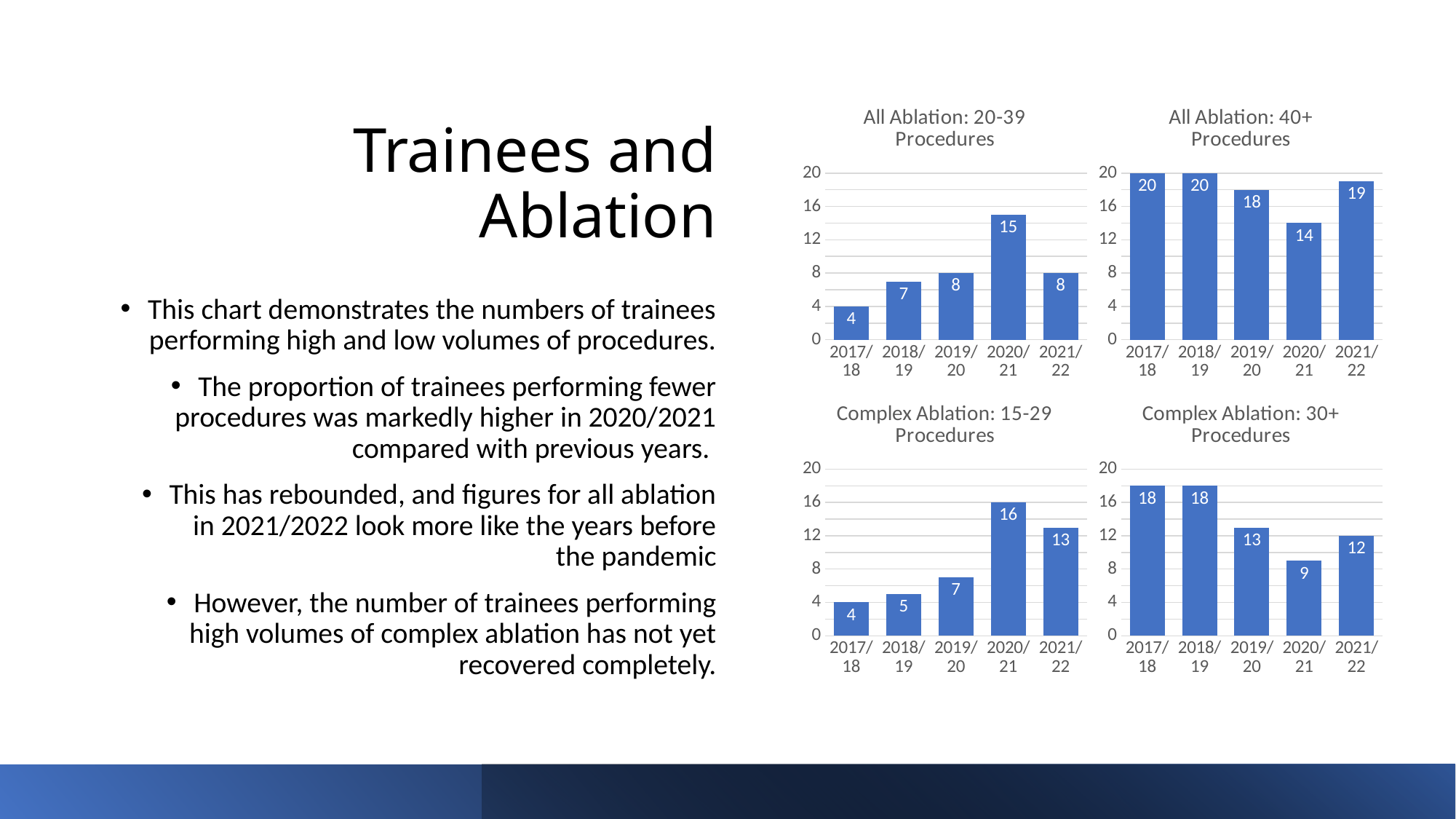
In the 'Complex Ablation: 30+ Procedures' chart, which year has the lowest value? 2020/21 In the 'All Ablation: 40+ Procedures' chart, is the value for 2021/22 larger or smaller than the value for 2020/21? larger In the 'Complex Ablation: 15-29 Procedures' chart, what is the difference between the 2020/21 value and the 2017/18 value? 12 How many charts are shown on the slide? 4 In the 'Complex Ablation: 30+ Procedures' chart, is the value for 2019/20 greater or less than 16? less In the 'Complex Ablation: 15-29 Procedures' chart, what is the value for 2021/22? 13 How many years are shown on the x axis of the 'Complex Ablation: 15-29 Procedures' chart? 5 In the 'All Ablation: 40+ Procedures' chart, what is the value for 2020/21? 14 In the 'All Ablation: 20-39 Procedures' chart, which year has the highest value? 2020/21 What kind of chart is the 'All Ablation: 40+ Procedures' chart? bar chart In the 'Complex Ablation: 15-29 Procedures' chart, do the values rise or fall from 2017/18 to 2020/21? rise In the 'All Ablation: 20-39 Procedures' chart, what is the value for 2020/21? 15